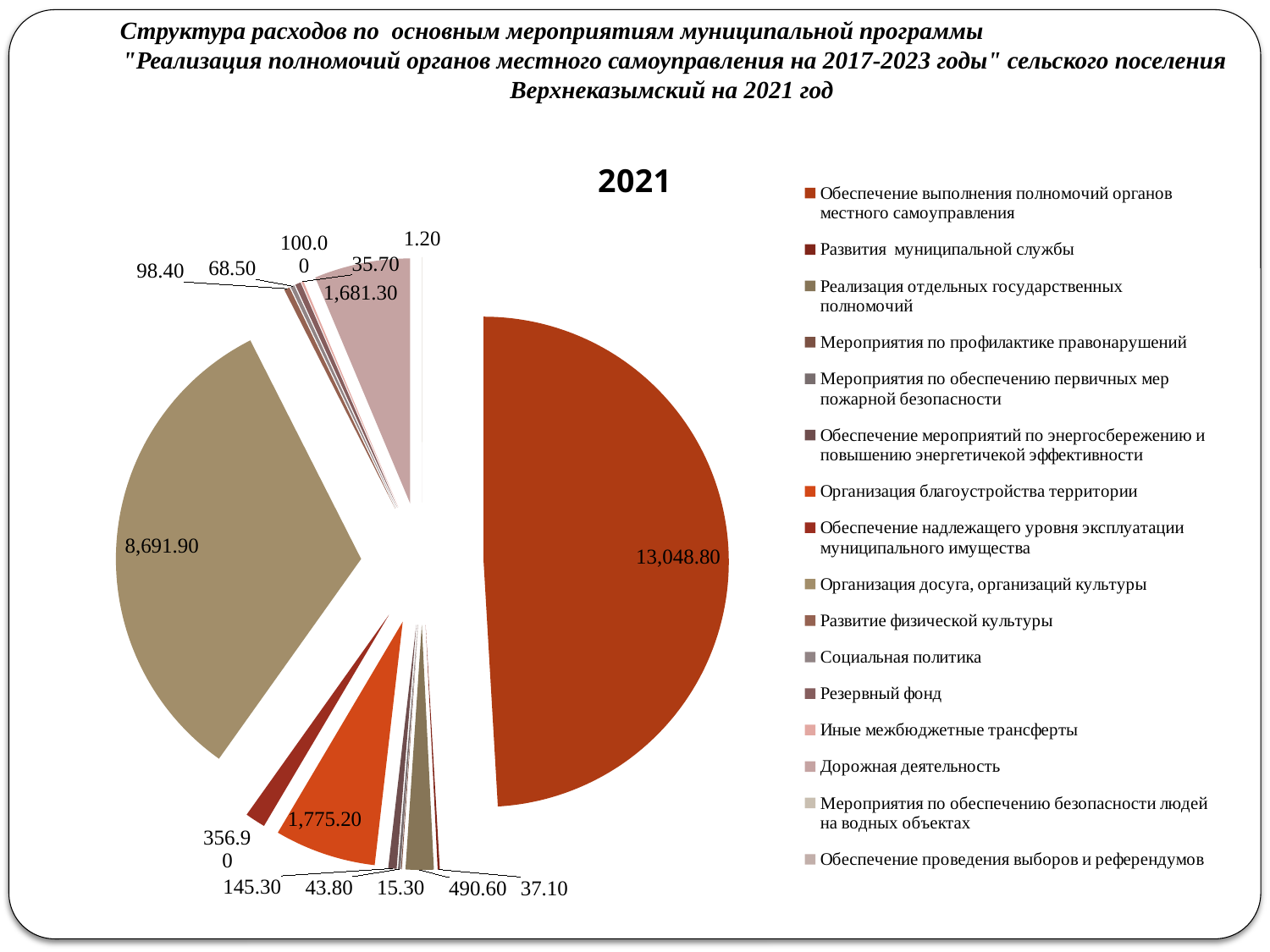
What kind of chart is shown on the slide? pie chart What is the value for Организация досуга, организаций культуры? 8,691.90 Which category has the largest slice in the pie chart? Обеспечение выполнения полномочий органов местного самоуправления Which is larger: the value for Организация благоустройства территории or the value for Дорожная деятельность? Организация благоустройства территории What is the difference between the values for Организация благоустройства территории and Дорожная деятельность? 93.90 What is the title shown above the pie chart? 2021 What is the smallest value labelled on the pie chart? 1.20 What is the difference between the values for Обеспечение выполнения полномочий органов местного самоуправления and Организация досуга, организаций культуры? 4,356.90 How many entries does the legend of the pie chart list? 16 What is the value of the largest slice in the pie chart? 13,048.80 What is the value for Организация благоустройства территории? 1,775.20 What is the value for Дорожная деятельность? 1,681.30